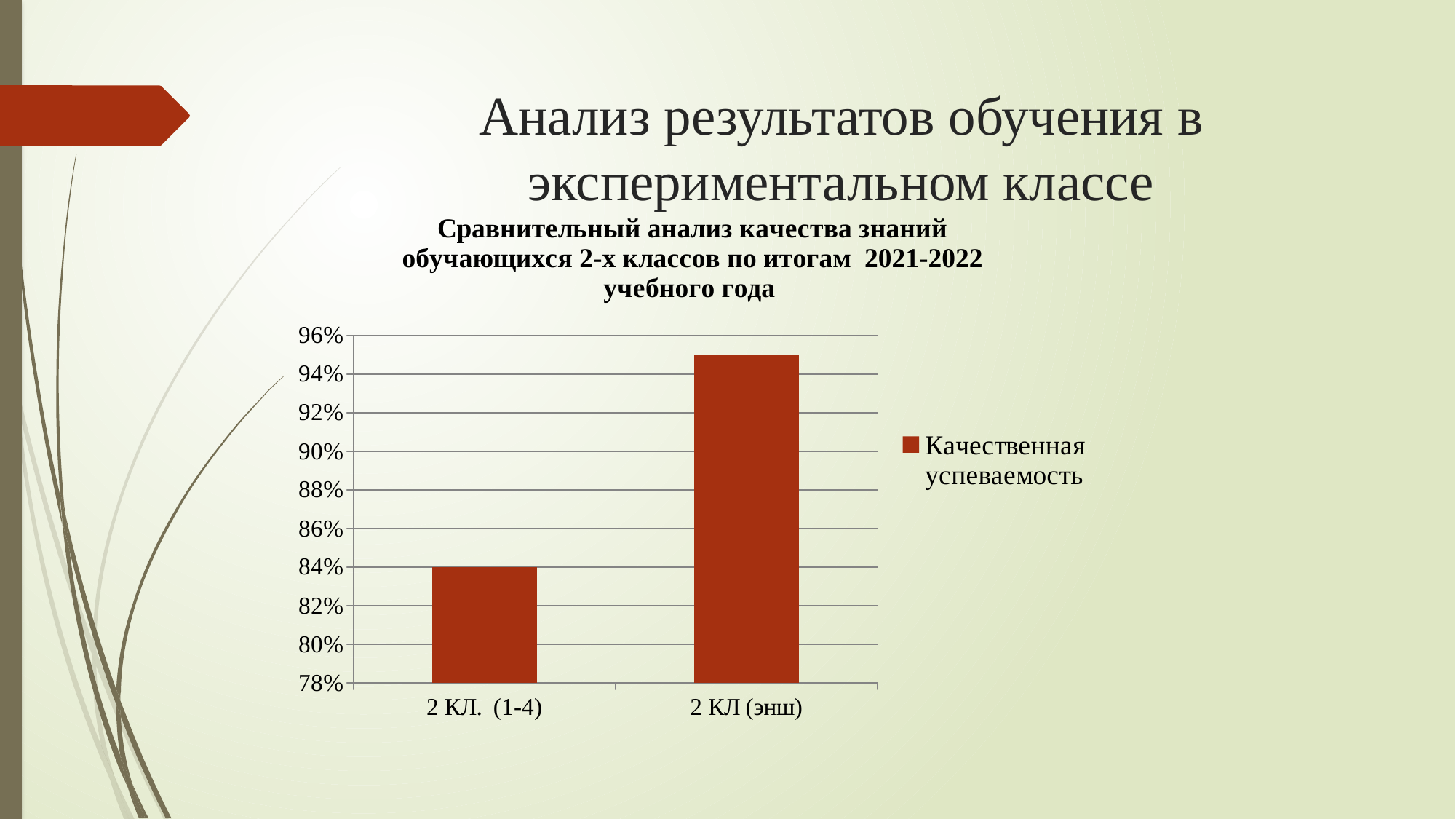
How many series does the chart legend list? 1 Which category has the highest value in the chart? 2 КЛ (энш) How many categories are shown on the x axis of the chart? 2 What type of chart is shown on the slide? bar chart What is the value for 2 КЛ. (1-4) in the chart? 84% Which is larger, the value for 2 КЛ. (1-4) or the value for 2 КЛ (энш)? 2 КЛ (энш) Is the value for 2 КЛ (энш) greater or less than 94%? greater What is the name of the series shown in the chart legend? Качественная успеваемость What is the lowest value shown on the chart's vertical axis? 78% Is the value for 2 КЛ (энш) greater or less than 96%? less Is the value for 2 КЛ. (1-4) greater or less than 90%? less Which category has the lowest value in the chart? 2 КЛ. (1-4)